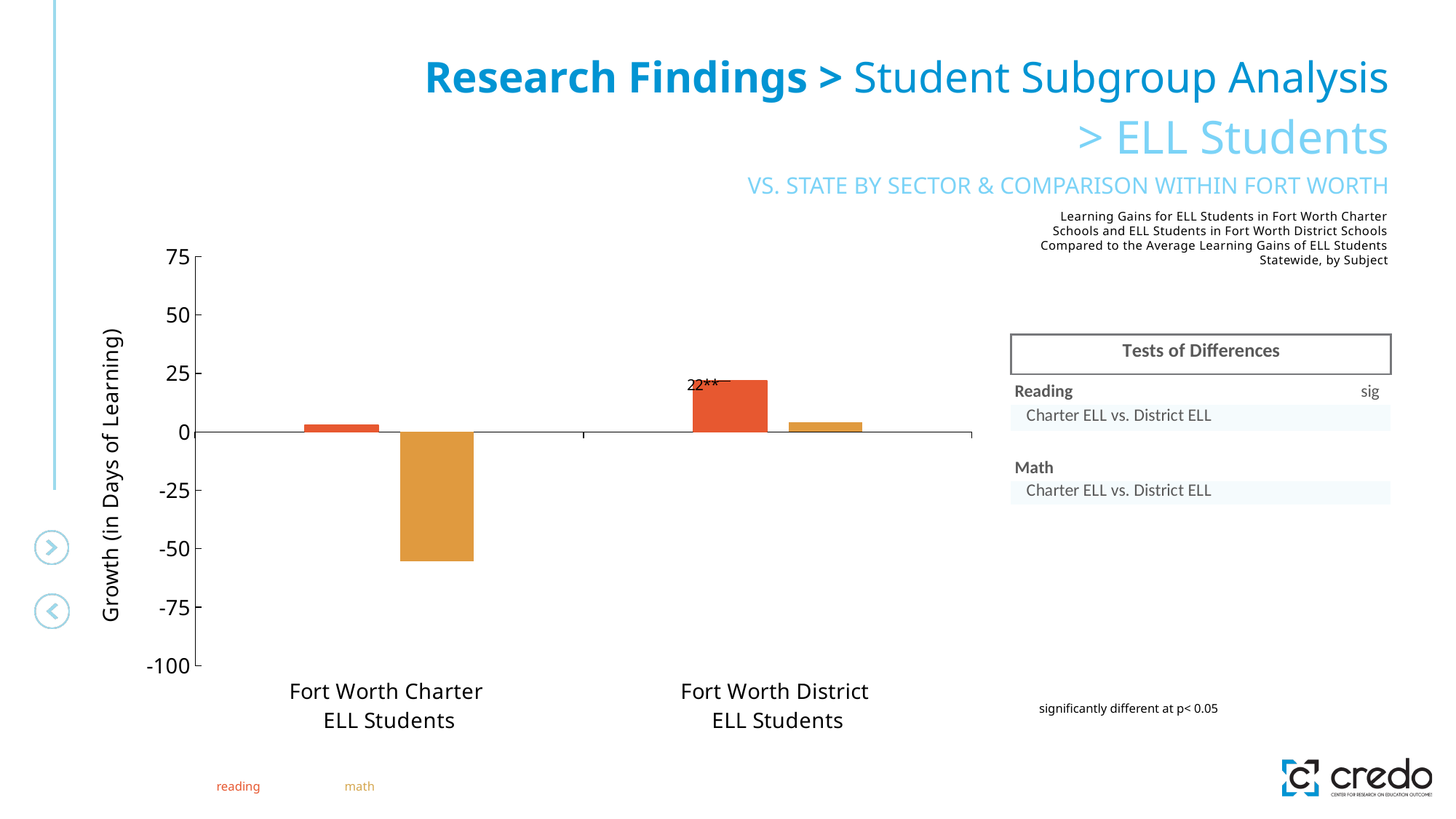
Which bar is the lowest in the chart? math for Fort Worth Charter ELL Students How many categories are shown on the x axis of the chart? 2 What is the reading value for Fort Worth District ELL Students? 22** Which bar is the highest in the chart? reading for Fort Worth District ELL Students Is the math value for Fort Worth District ELL Students greater or less than 25? less How many series does the chart's legend list? 2 Is the math value for Fort Worth Charter ELL Students greater or less than -50? less What kind of chart is shown on the slide? bar chart Which is larger, the math value for Fort Worth Charter ELL Students or the math value for Fort Worth District ELL Students? Fort Worth District ELL Students What is the title of the chart's y axis? Growth (in Days of Learning) Which is larger, the reading value for Fort Worth Charter ELL Students or the reading value for Fort Worth District ELL Students? Fort Worth District ELL Students Is the math value for Fort Worth Charter ELL Students greater or less than -25? less